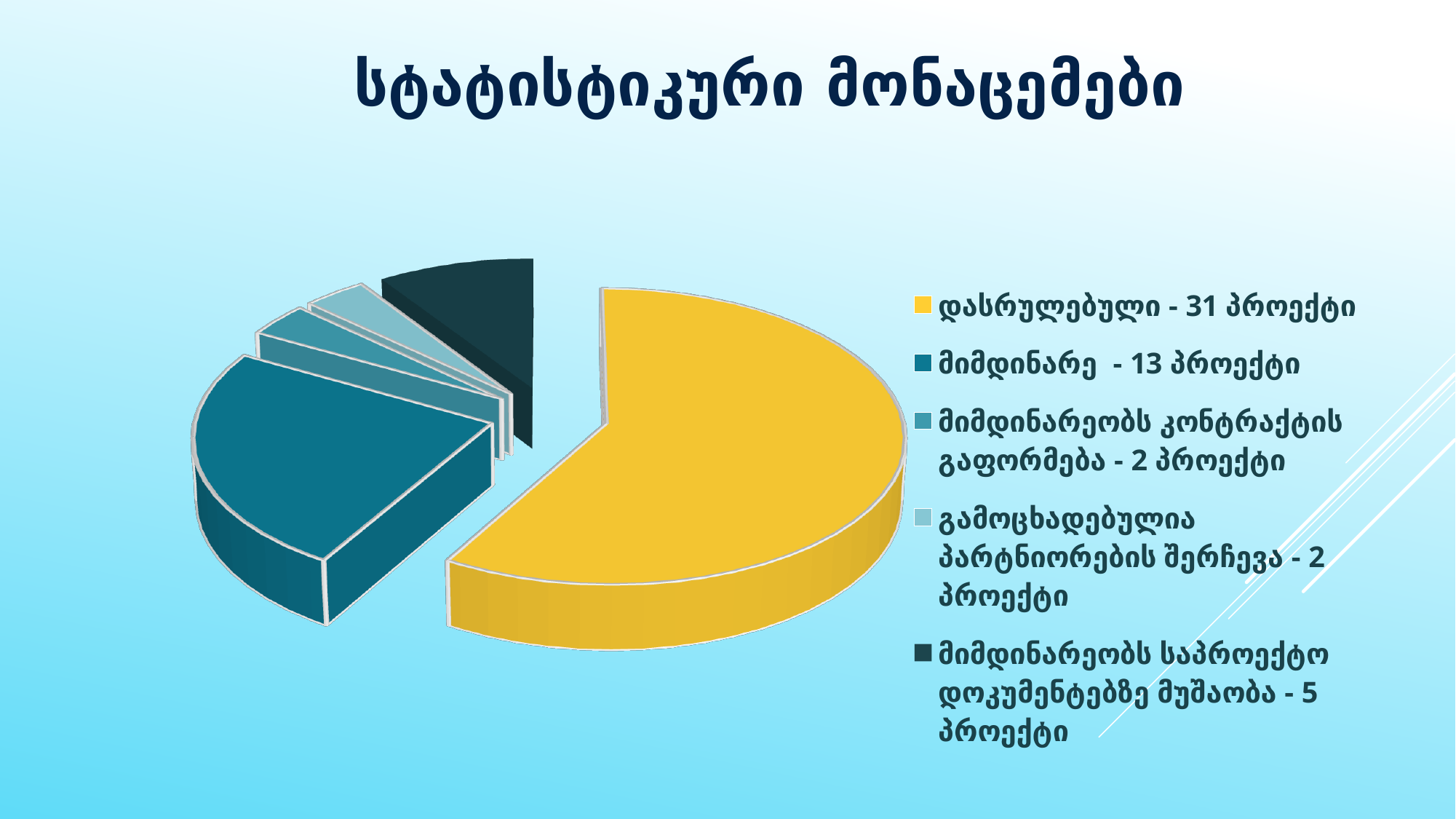
What is the difference between the number of დასრულებული projects and მიმდინარე projects? 18 How many projects are listed for დასრულებული in the legend? 31 პროექტი What colour is the slice for დასრულებული? yellow What is the total number of projects across all slices of the pie? 53 Which is larger: მიმდინარე or მიმდინარეობს საპროექტო დოკუმენტებზე მუშაობა? მიმდინარე What is the title of the slide? სტატისტიკური მონაცემები How many slices does the pie chart have? 5 How many projects are listed for მიმდინარეობს საპროექტო დოკუმენტებზე მუშაობა? 5 პროექტი What kind of chart is shown on the slide? pie chart How many projects are listed for მიმდინარე? 13 პროექტი How many projects are listed for მიმდინარეობს კონტრაქტის გაფორმება? 2 პროექტი Which category has the largest slice of the pie? დასრულებული